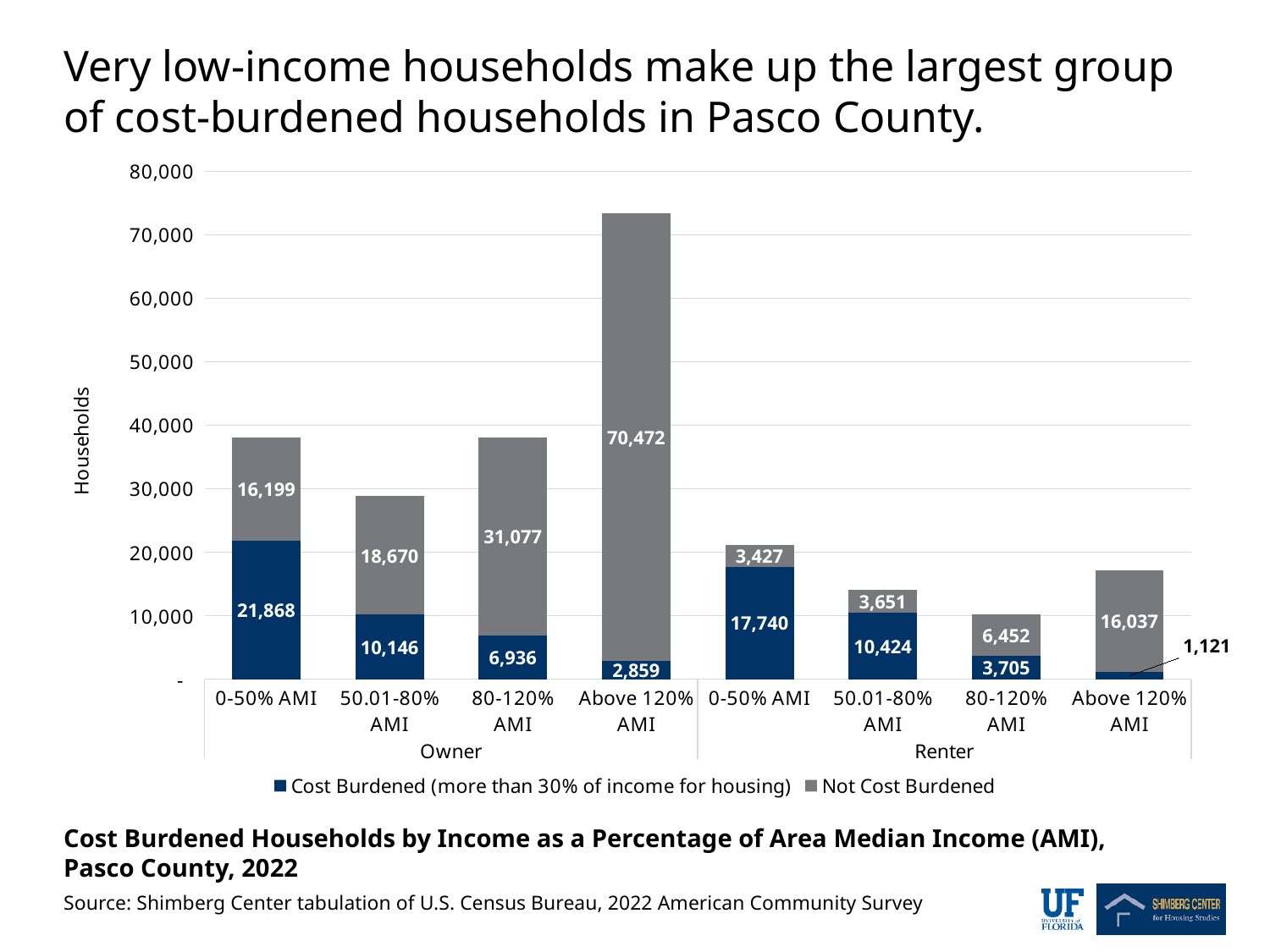
Is the total height of the Owner Above 120% AMI bar greater or less than 70,000? greater How many series does the legend list? 2 How many income categories are plotted along the x axis in total? 8 How many cost-burdened owner households are in the 0-50% AMI group? 21,868 Which category has the highest number of cost-burdened households? Owner 0-50% AMI Which is larger: the number of cost-burdened renter households at 50.01-80% AMI or the number of cost-burdened owner households at 50.01-80% AMI? Renter 50.01-80% AMI (10,424) How many cost-burdened renter households are in the Above 120% AMI group? 1,121 Which category has the lowest number of cost-burdened households? Renter Above 120% AMI What is the total number of renter households in the 0-50% AMI group (cost burdened plus not cost burdened)? 21,167 How many not-cost-burdened owner households are in the Above 120% AMI group? 70,472 What is the difference between cost-burdened owner households and cost-burdened renter households in the 0-50% AMI group? 4,128 What kind of chart is shown on the slide? Stacked bar chart